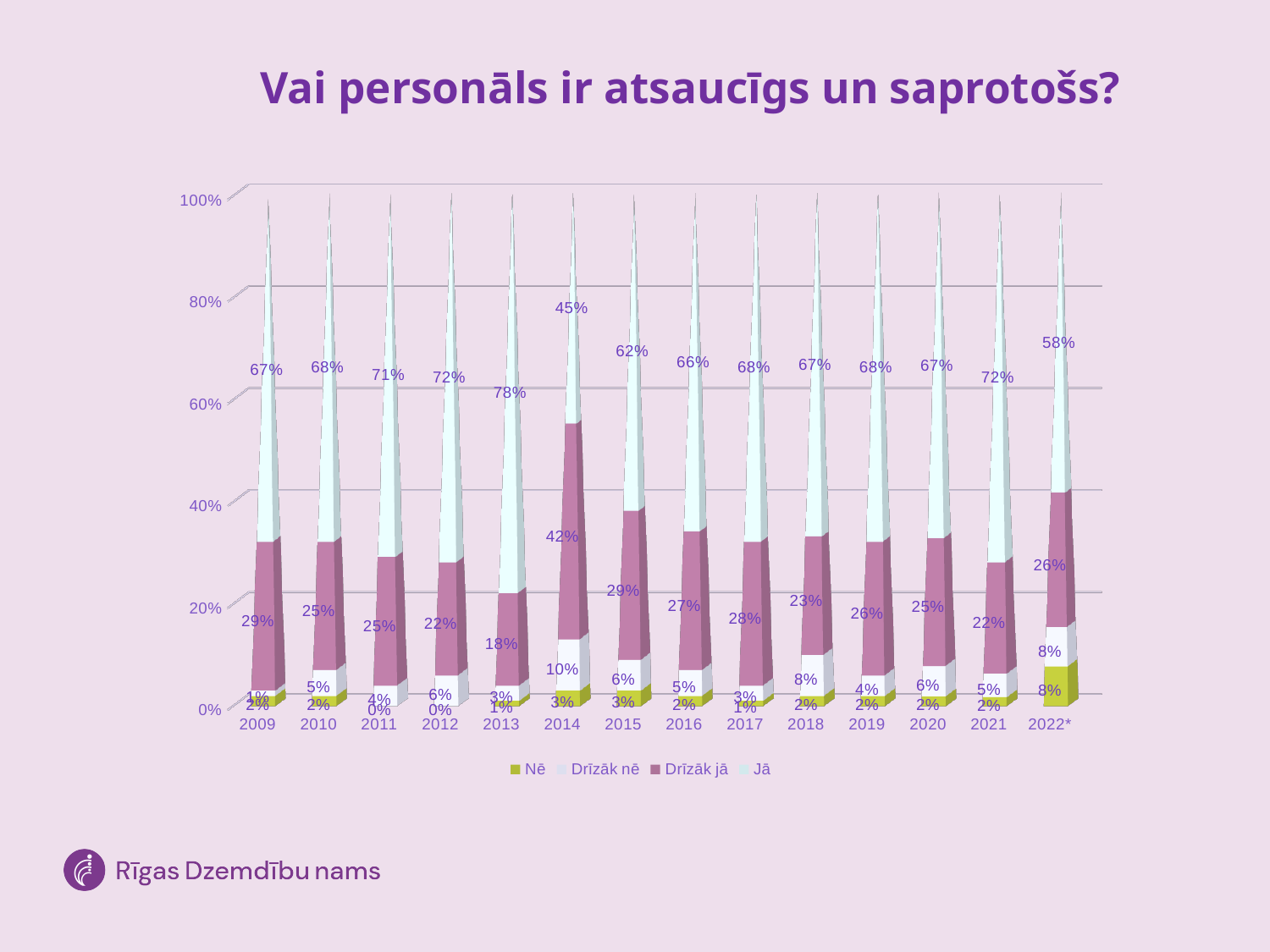
What is the value for "Jā" in 2013? 78% What is the value for "Drīzāk nē" in 2018? 8% What is the difference between the "Jā" values for 2013 and 2014? 33% Which is larger: the "Drīzāk jā" value in 2014 or in 2021? 2014 What kind of chart is shown on the slide? Stacked bar chart How many series does the legend list? 4 How many years are shown on the x axis? 14 In which year is the "Jā" value highest? 2013 What is the value for "Nē" in 2022*? 8% What is the title of the chart? Vai personāls ir atsaucīgs un saprotošs? In which year is the "Jā" value lowest? 2014 What is the value for "Drīzāk jā" in 2014? 42%